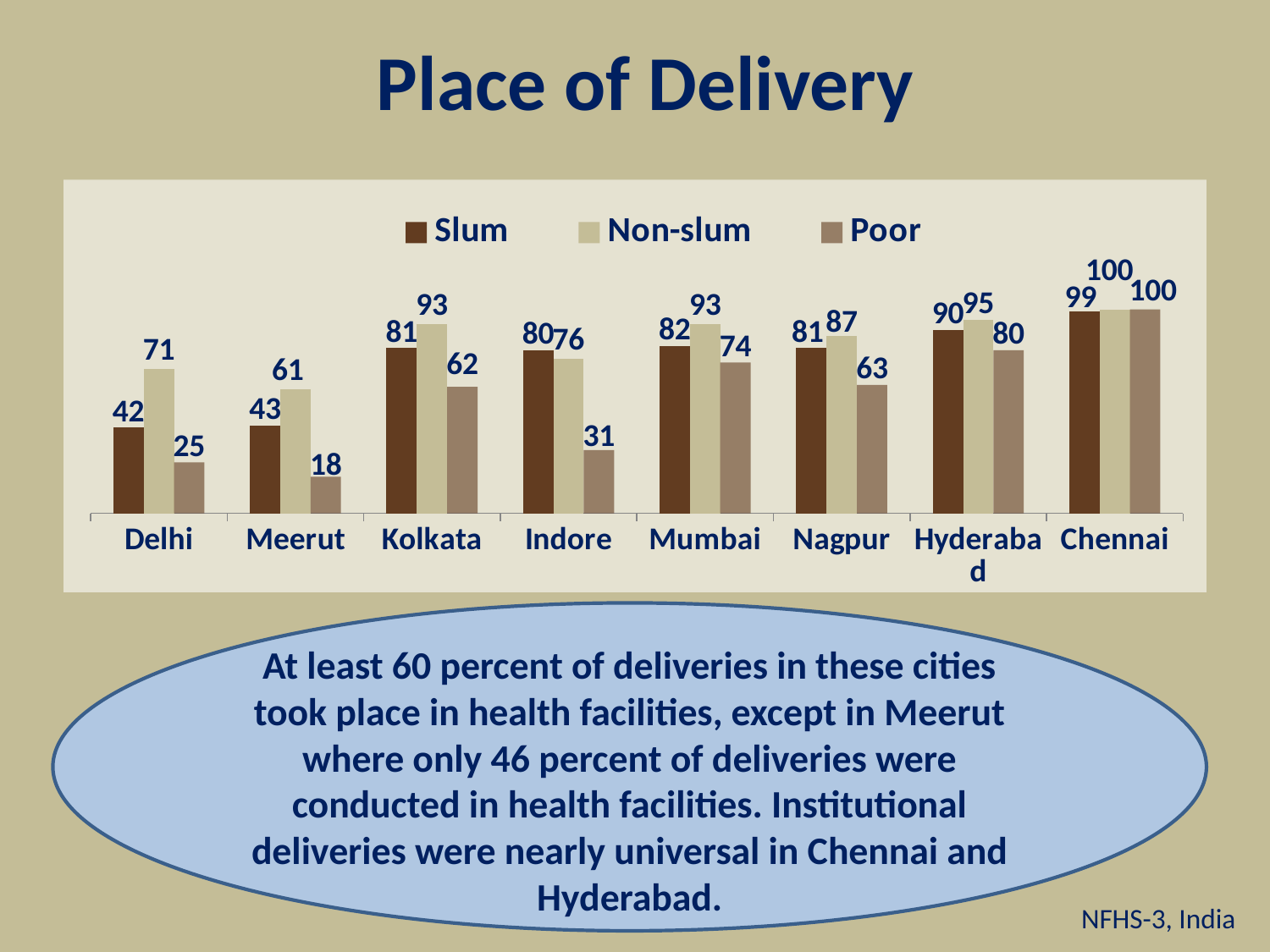
What kind of chart is shown on the slide? Bar chart What is the title of the slide containing the chart? Place of Delivery What is the Poor value for Meerut? 18 Which is larger for Indore, the Slum value or the Non-slum value? Slum What is the Poor value for Indore? 31 What is the Non-slum value for Kolkata? 93 Which city has the highest Slum value? Chennai How many series does the legend list? 3 How many cities are shown on the x axis? 8 What is the Slum value for Delhi? 42 Which city has the lowest Poor value? Meerut What is the difference between the Non-slum and Slum values for Delhi? 29